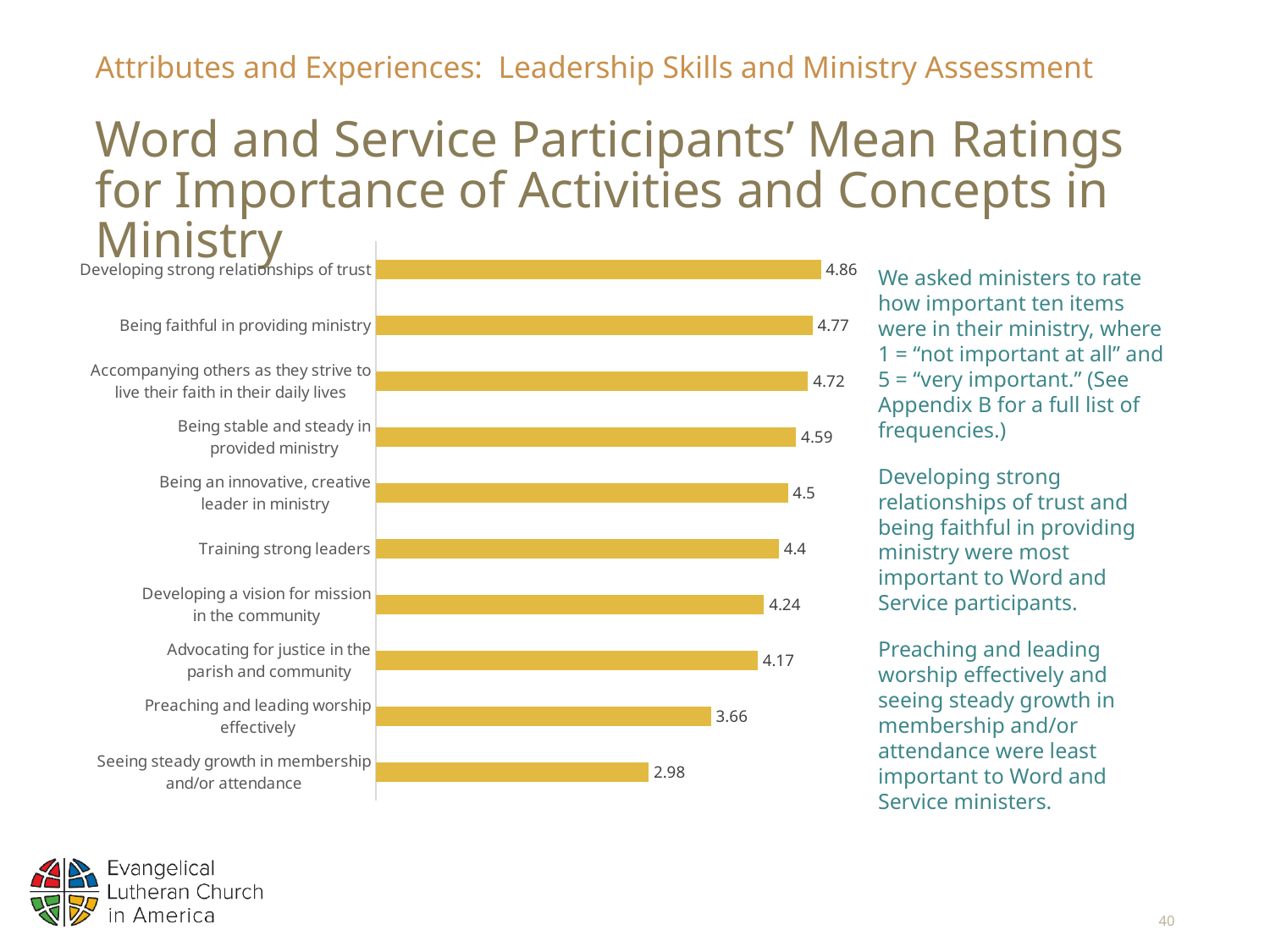
What kind of chart is shown on the slide? Bar chart What is the mean rating for "Advocating for justice in the parish and community"? 4.17 What colour are the bars in the chart? Gold Which has a higher mean rating: "Developing a vision for mission in the community" or "Preaching and leading worship effectively"? Developing a vision for mission in the community Which item has the highest mean rating? Developing strong relationships of trust What is the mean rating for "Preaching and leading worship effectively"? 3.66 How many items are shown in the chart? 10 Which item has the lowest mean rating? Seeing steady growth in membership and/or attendance What is the mean rating for "Training strong leaders"? 4.4 What is the mean rating for "Developing strong relationships of trust"? 4.86 What is the difference between the mean ratings for "Being faithful in providing ministry" and "Seeing steady growth in membership and/or attendance"? 1.79 What is the difference between the mean ratings for "Being stable and steady in provided ministry" and "Being an innovative, creative leader in ministry"? 0.09